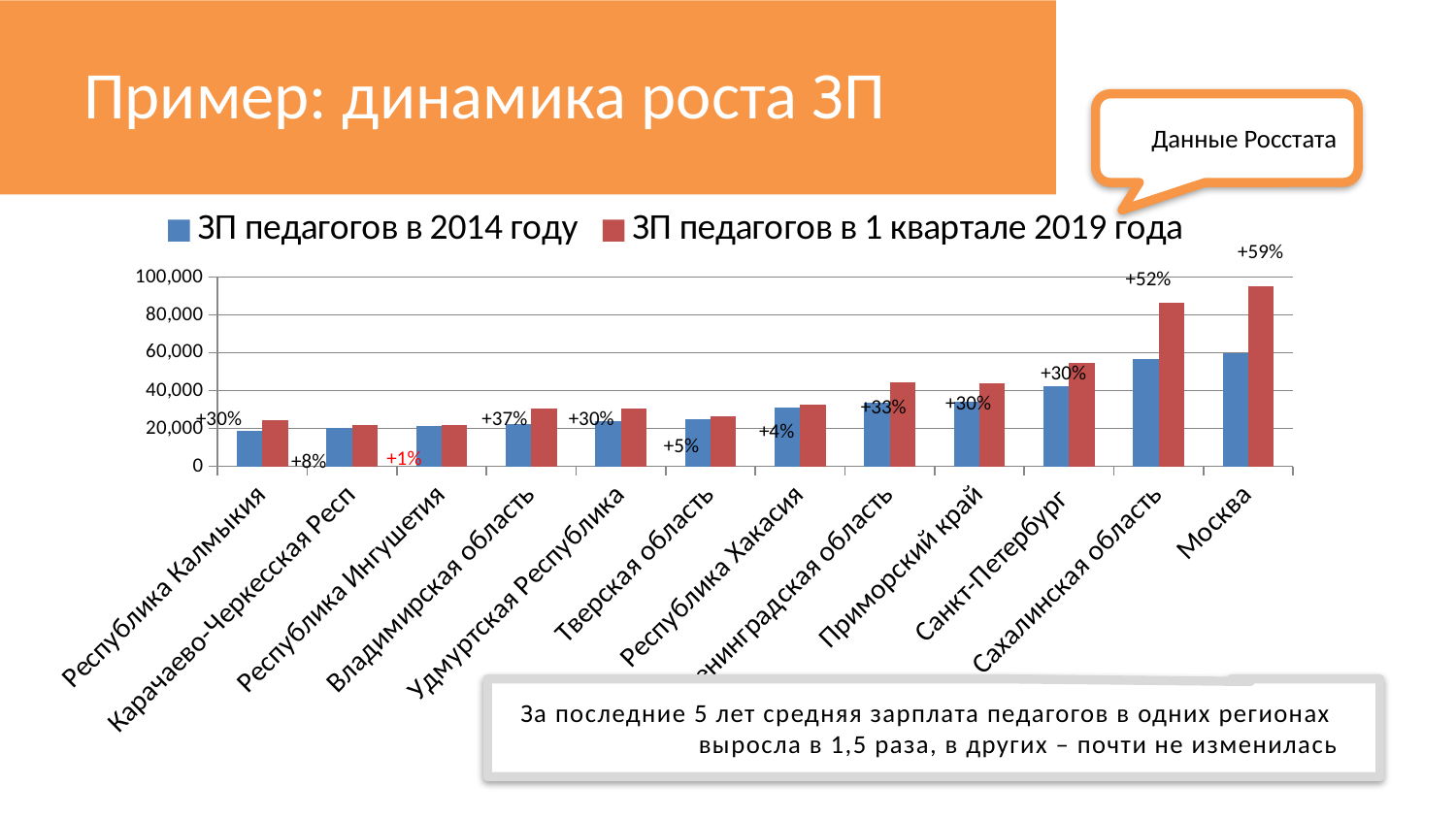
How many regions are shown on the x axis of the chart? 12 Which region has the lowest labelled growth percentage? Республика Ингушетия What growth percentage is labelled for Сахалинская область? +52% What growth percentage is labelled for Республика Ингушетия? +1% Which is larger: the 2019 value for Ленинградская область or the 2019 value for Республика Хакасия? Ленинградская область What kind of chart is shown on the slide? bar chart Which region has the highest teacher salary in the 1st quarter of 2019? Москва Is the value for Москва in the 1st quarter of 2019 greater or less than 80,000? greater Do the salary values generally rise or fall from left to right along the x axis? rise How many series does the legend list? 2 What growth percentage is labelled for Москва? +59%